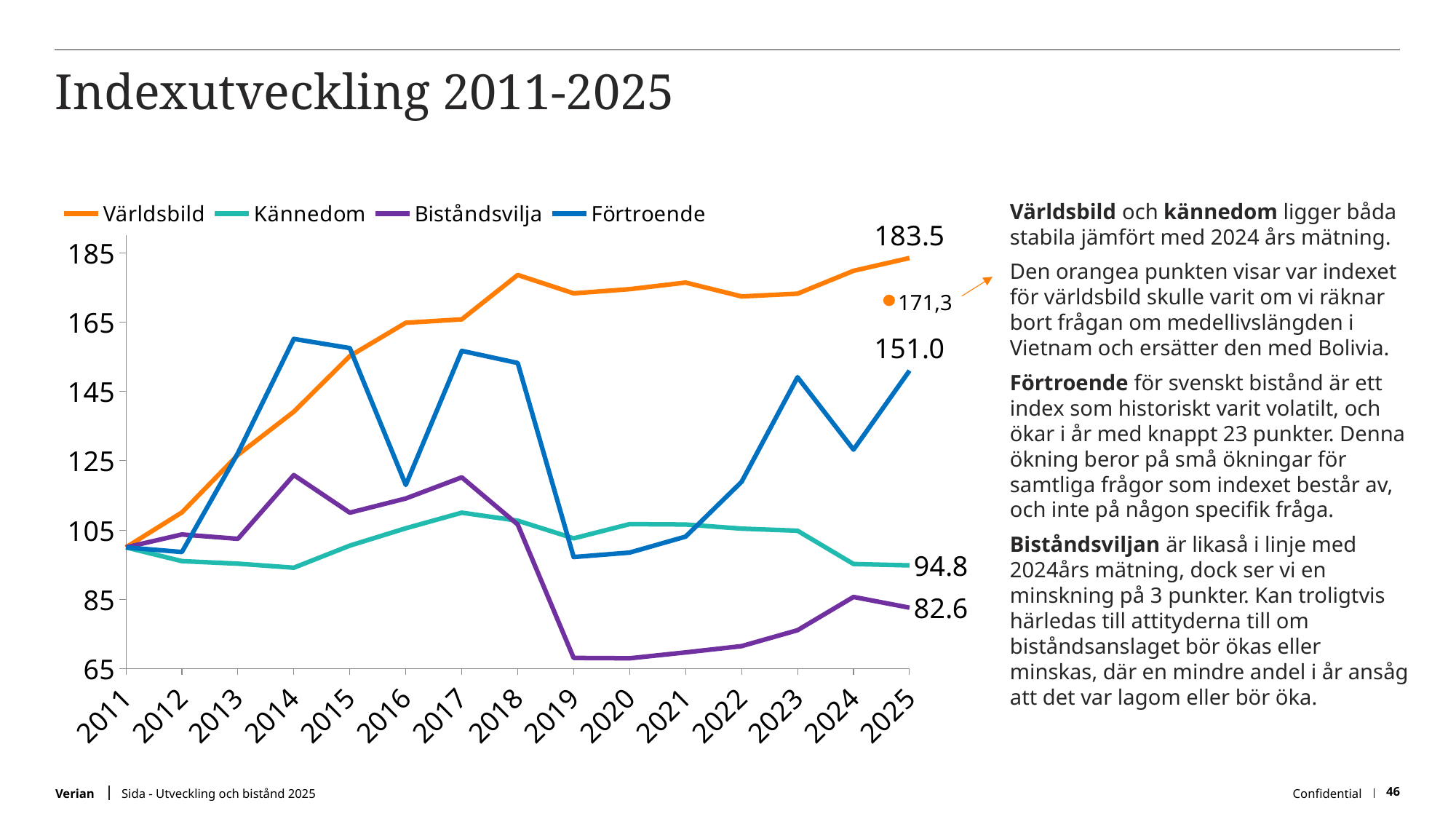
What is the value of Förtroende in 2025? 151.0 How many years are shown along the x axis of the chart? 15 What is the value of Världsbild in 2025? 183.5 Is the value for Förtroende in 2014 greater or less than 145? greater Does the Världsbild line generally rise or fall from 2011 to 2025? rise What is the value of Biståndsvilja in 2025? 82.6 How many series does the chart legend list? 4 What is the value of Kännedom in 2025? 94.8 Which series has the highest value in 2025? Världsbild What kind of chart is shown on the slide? line chart What is the difference between Världsbild and Förtroende in 2025? 32.5 Which series has the lowest value in 2025? Biståndsvilja